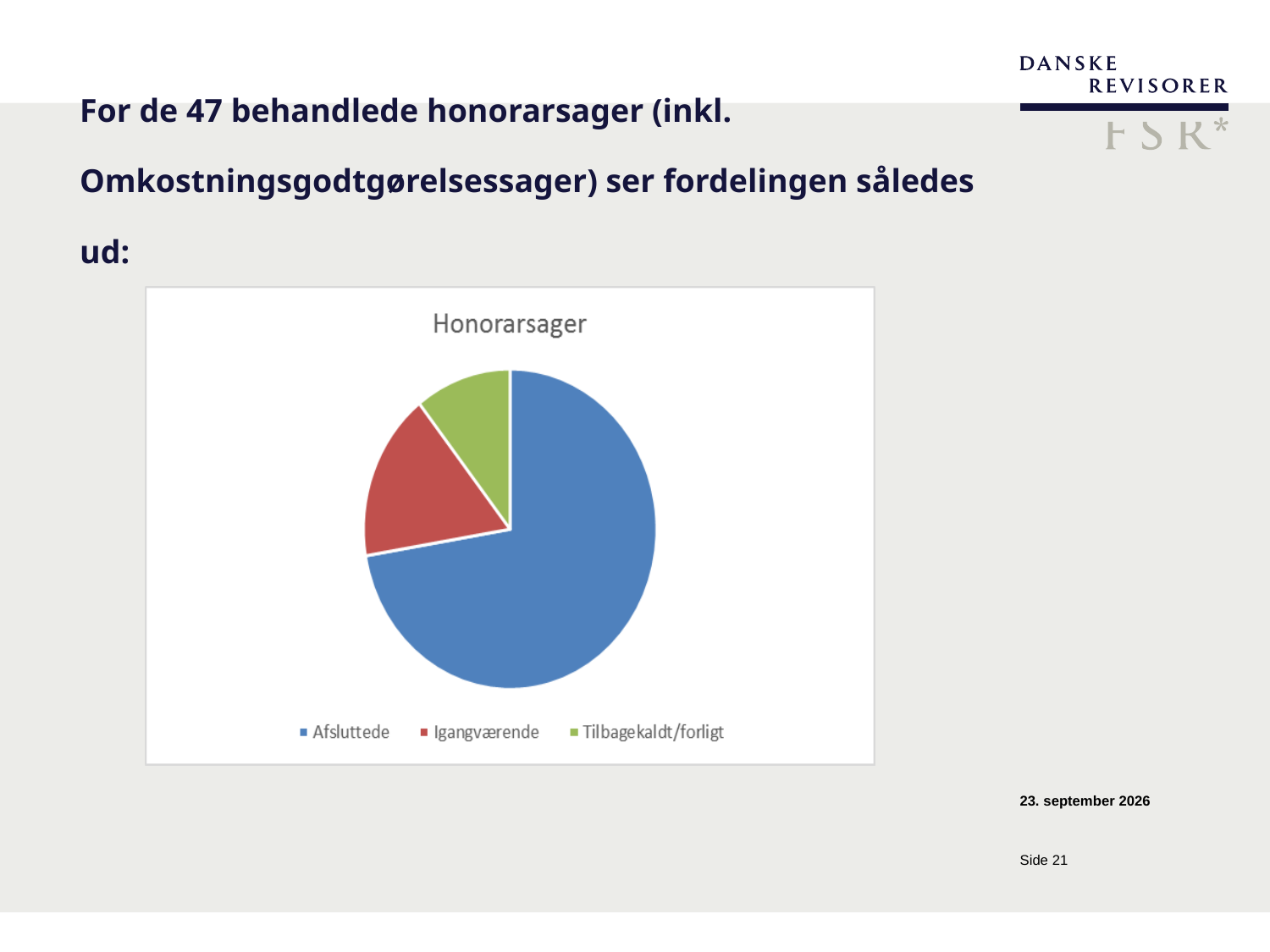
Which category has the smallest slice of the pie? Tilbagekaldt/forligt Does the Afsluttede slice make up more or less than half of the pie? More Which slice is larger, Igangværende or Tilbagekaldt/forligt? Igangværende What kind of chart is shown on the slide? Pie chart Which category has the largest slice of the pie? Afsluttede What colour is the Afsluttede slice? Blue What is the title of the chart? Honorarsager How many entries does the chart legend list? 3 How many slices does the pie chart have? 3 Which slice is larger, Afsluttede or Igangværende? Afsluttede